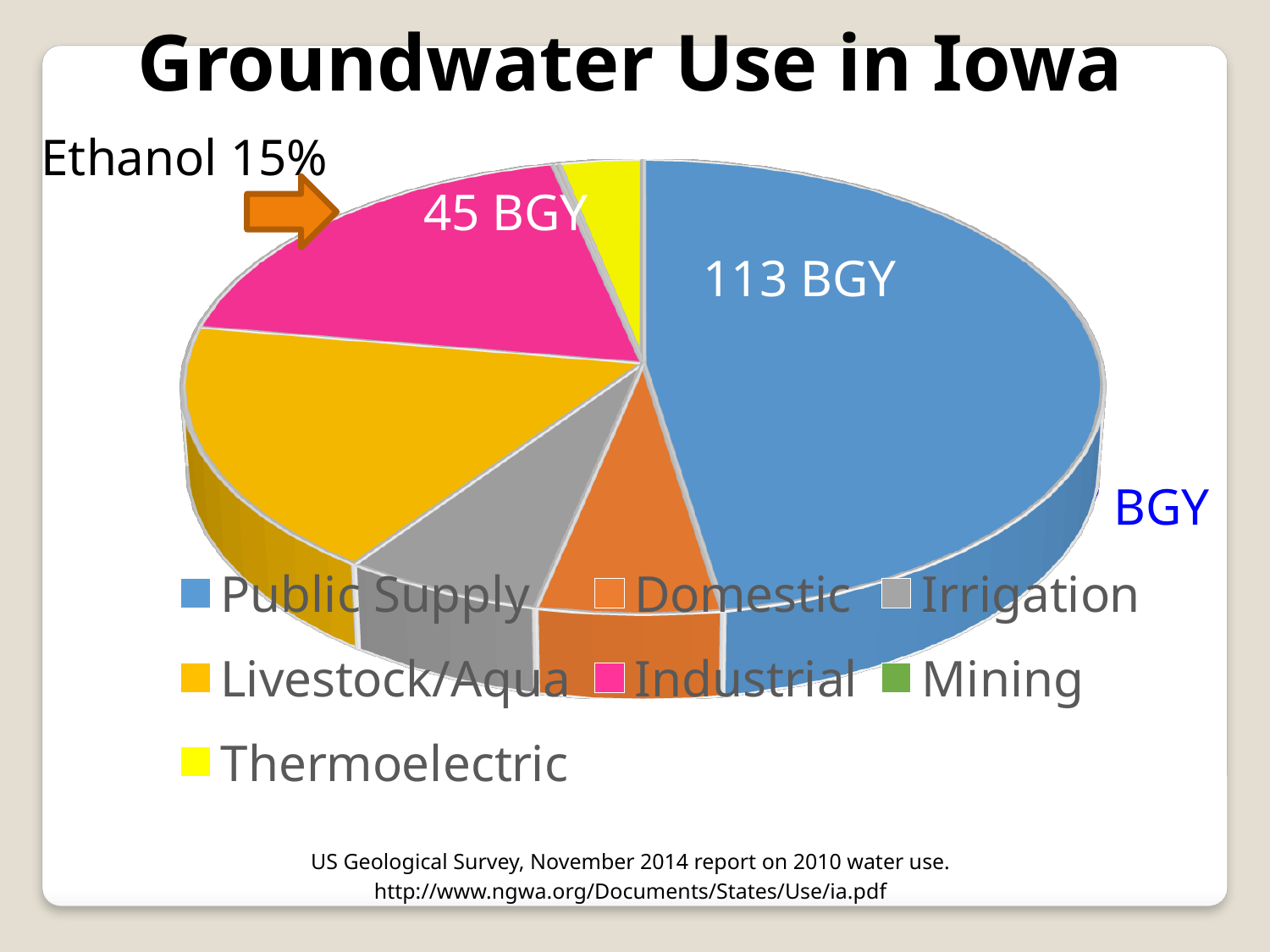
Which is larger, the Livestock/Aqua slice or the Irrigation slice? Livestock/Aqua What kind of chart is shown on the slide? Pie chart Which is larger, the Livestock/Aqua slice or the Thermoelectric slice? Livestock/Aqua Which slice does the 'Ethanol 15%' arrow point to? Industrial What is the value shown for the Industrial slice? 45 BGY Which category has the largest slice of the pie? Public Supply What is the value shown for the Public Supply slice? 113 BGY How many categories does the legend list? 7 What is the difference between the Public Supply value and the Industrial value? 68 BGY What is the title of the chart? Groundwater Use in Iowa Which is larger, the Public Supply slice or the Industrial slice? Public Supply